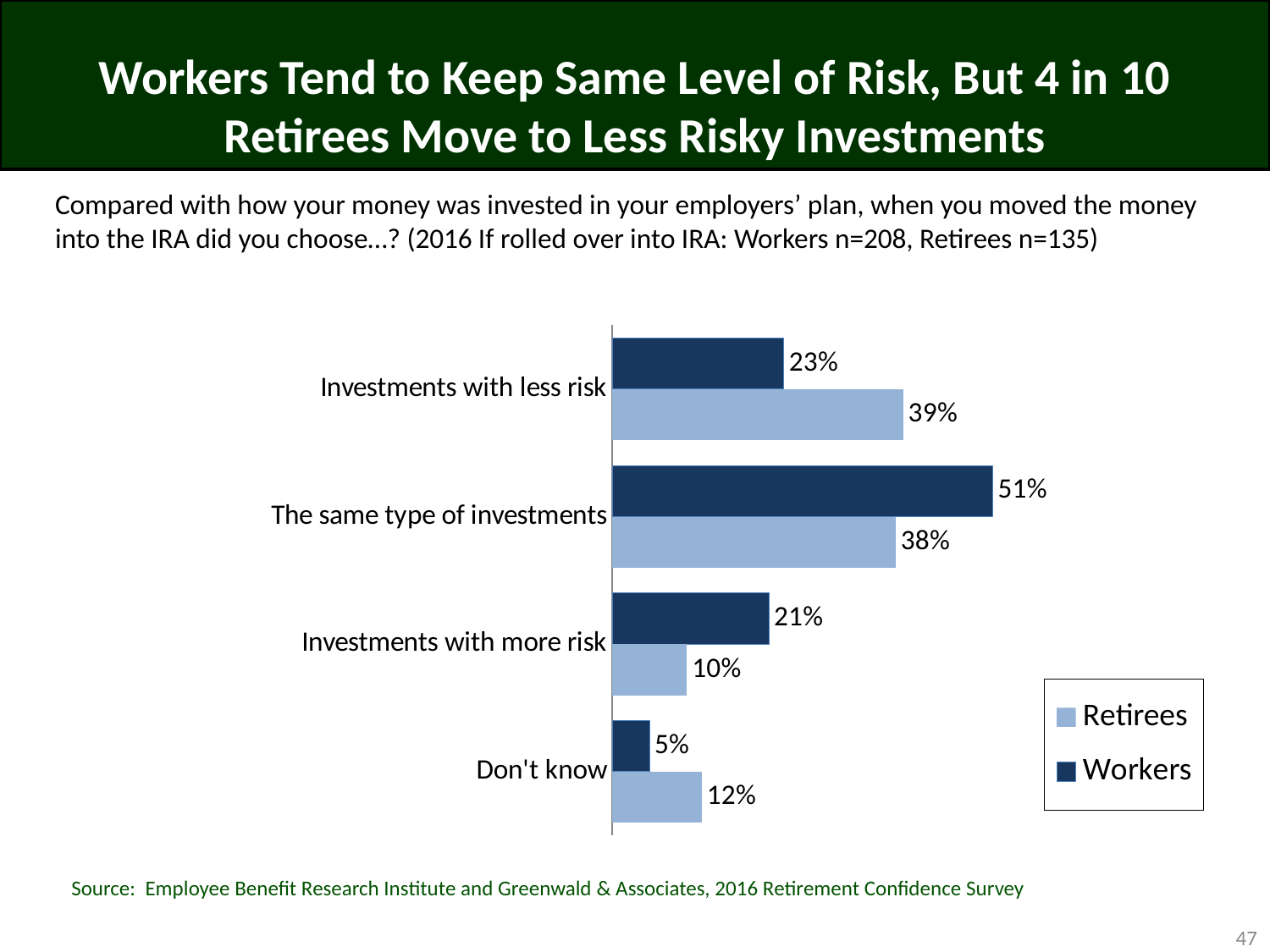
For investments with less risk, which group has the larger value, Workers or Retirees? Retirees What kind of chart is shown on the slide? Bar chart What percentage of Workers chose investments with less risk? 23% What percentage of Retirees answered 'Don't know'? 12% What percentage of Workers chose the same type of investments? 51% How many categories are shown on the chart? 4 Which series is shown in the lighter blue colour? Retirees Which category has the highest value for Workers? The same type of investments How many series does the legend list? 2 Which category has the lowest value for Retirees? Investments with more risk What percentage of Retirees chose investments with less risk? 39% What is the difference between the Workers and Retirees values for investments with more risk? 11%